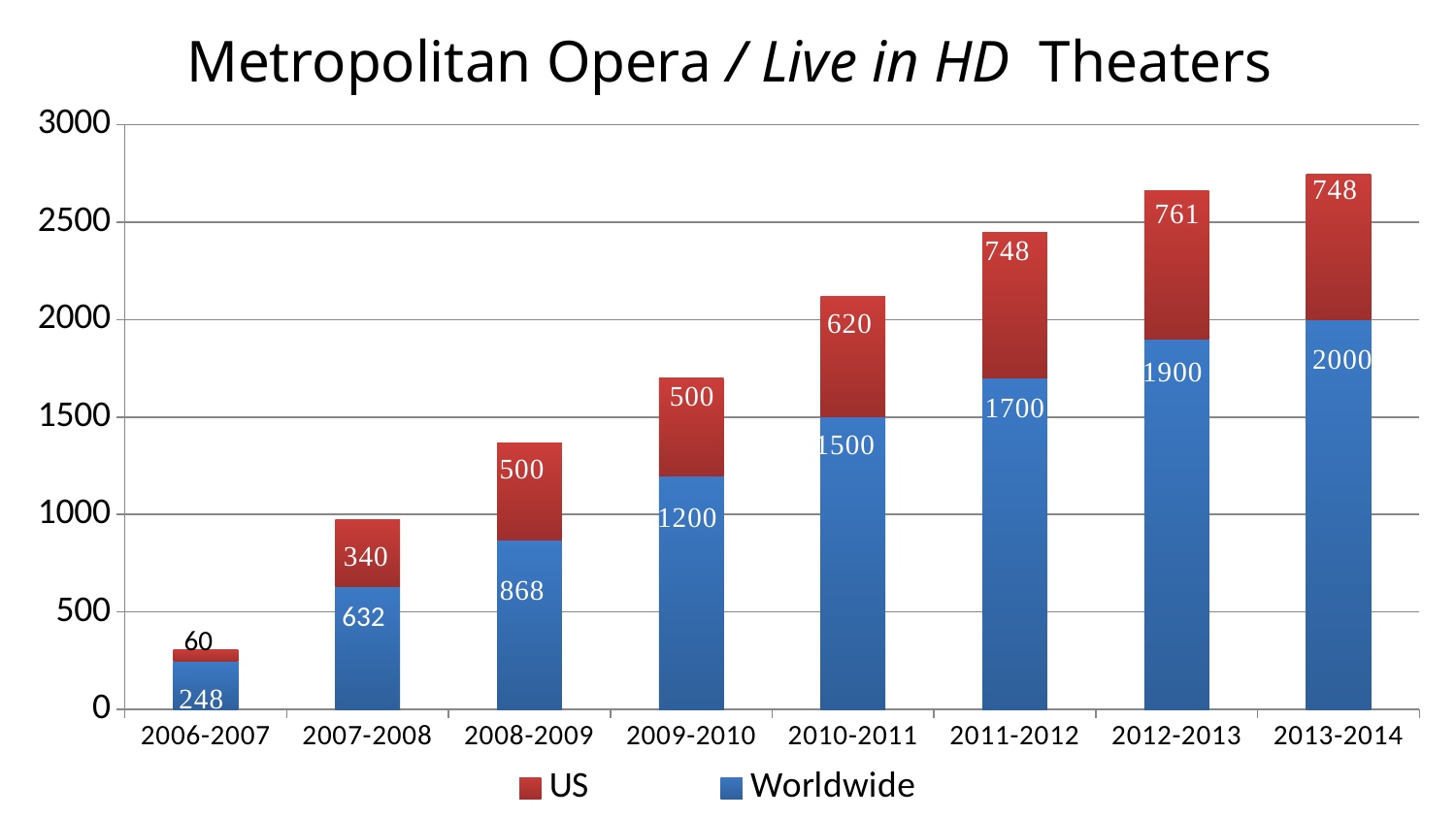
What kind of chart is this? Stacked bar chart Which season has the highest Worldwide value? 2013-2014 What is the total of the stacked bar for 2011-2012? 2448 What is the difference between the Worldwide values for 2013-2014 and 2012-2013? 100 What is the Worldwide value for 2006-2007? 248 Which season has the lowest US value? 2006-2007 Do the Worldwide values rise or fall from 2006-2007 to 2013-2014? Rise What is the US value for 2012-2013? 761 Which is larger, the US value for 2010-2011 or the US value for 2009-2010? 2010-2011 How many seasons are shown on the x axis? 8 What is the Worldwide value for 2009-2010? 1200 How many series does the legend list? 2